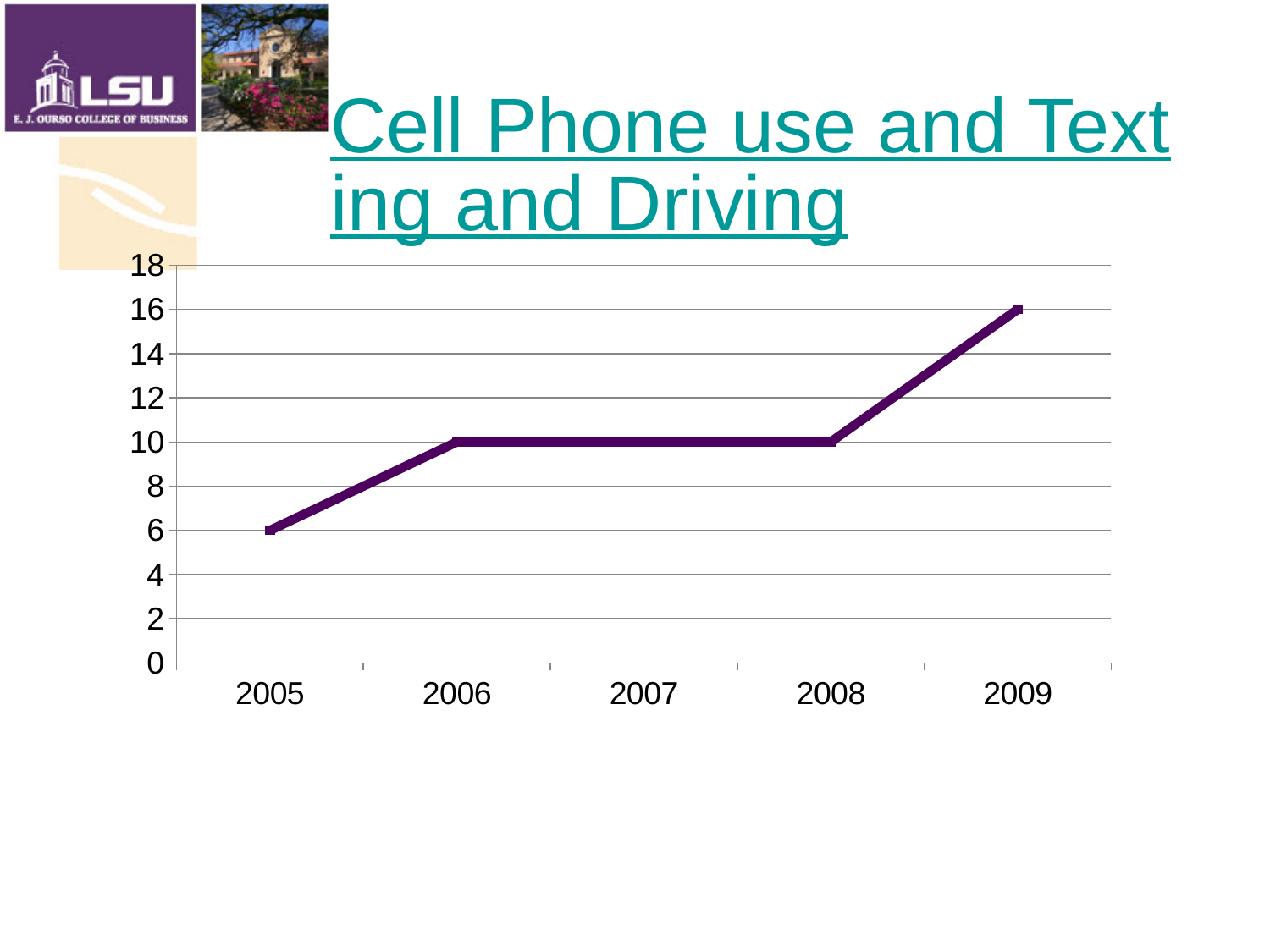
What is the value for 2006? 10 How many years are labeled on the x axis? 5 What type of chart is shown on the slide? line chart What is the value for 2005? 6 Which is larger, the value for 2006 or the value for 2009? 2009 What is the difference between the values for 2009 and 2005? 10 Which year has the lowest value? 2005 What is the value for 2009? 16 What is the value for 2008? 10 Do the values rise or fall from 2005 to 2009? rise Is the value for 2009 greater or less than 14? greater Which year has the highest value? 2009